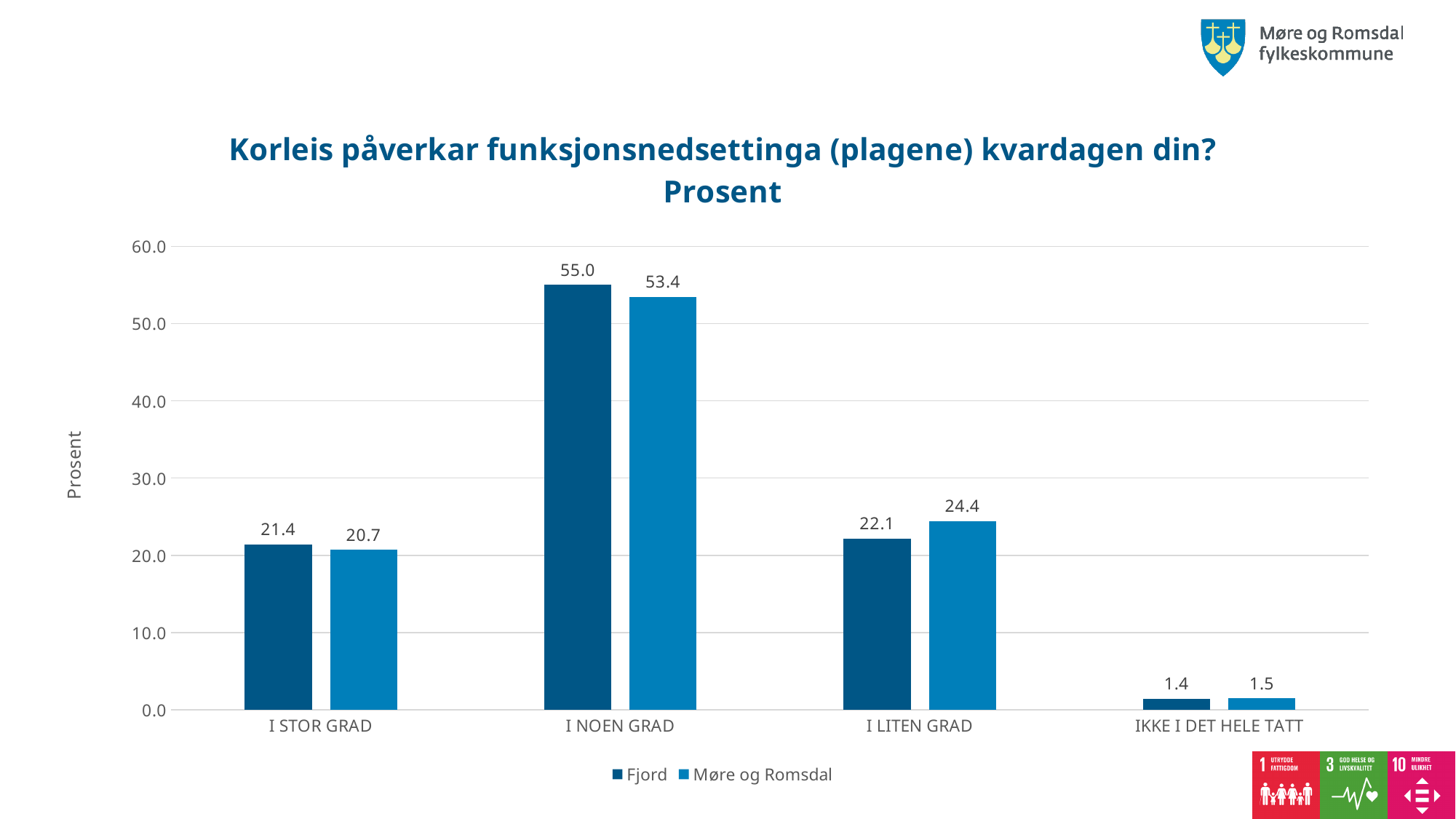
What is the label of the vertical axis? Prosent In the 'I LITEN GRAD' category, which series has the larger value, Fjord or Møre og Romsdal? Møre og Romsdal Which category has the highest value for Møre og Romsdal? I NOEN GRAD What is the value for Møre og Romsdal in the 'I LITEN GRAD' category? 24.4 What kind of chart is shown on the slide? Bar chart What is the value for Fjord in the 'I NOEN GRAD' category? 55.0 How many series does the legend list? 2 How many categories are shown on the x axis? 4 Which category has the lowest value for Fjord? IKKE I DET HELE TATT Is the value for Fjord in 'I NOEN GRAD' greater or less than 50.0? greater What is the value for Fjord in the 'IKKE I DET HELE TATT' category? 1.4 What is the difference between the Fjord and Møre og Romsdal values in the 'I STOR GRAD' category? 0.7